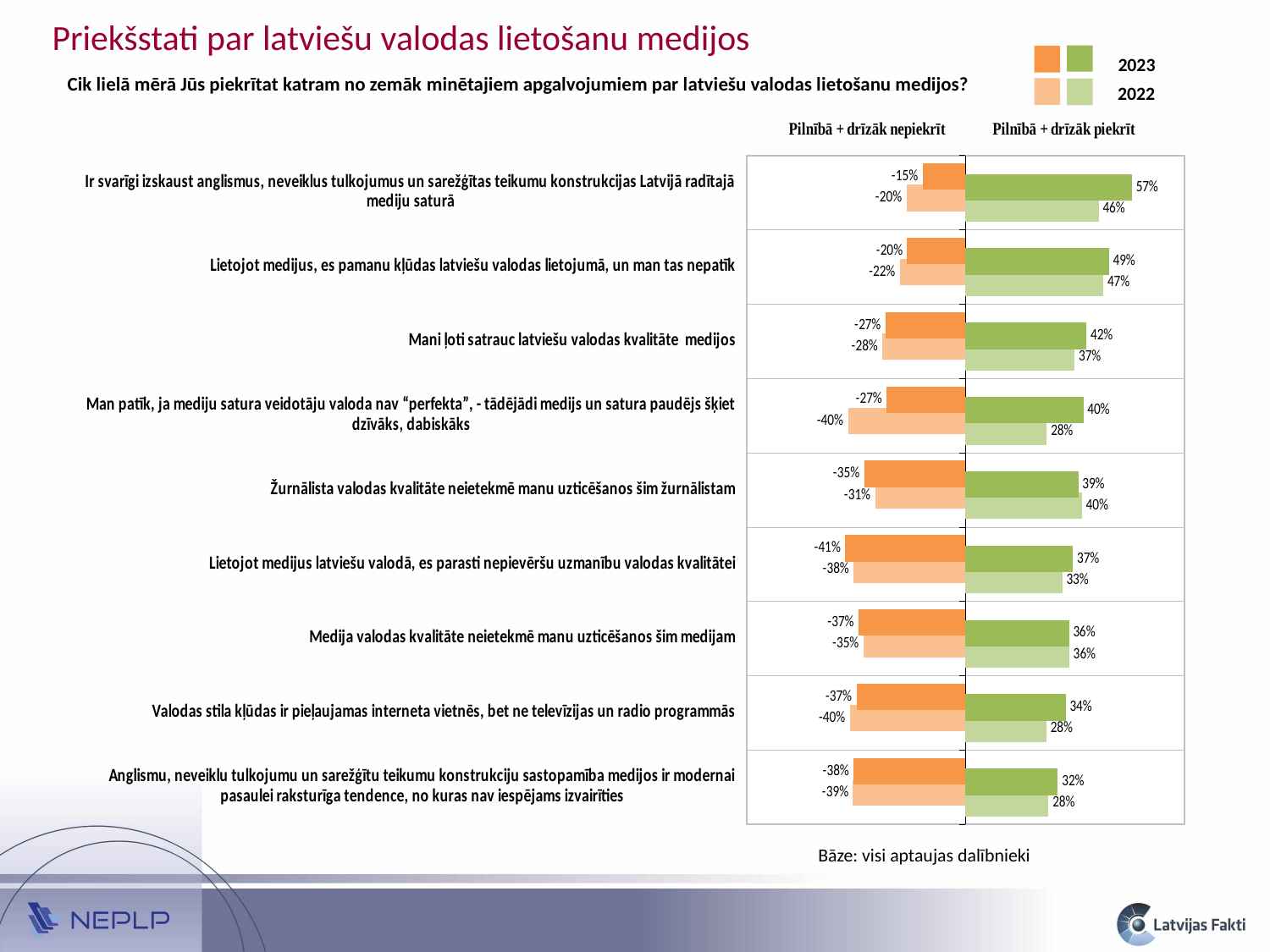
How many years does the legend list? 2 What is the 2023 'Pilnībā + drīzāk nepiekrīt' value for 'Lietojot medijus latviešu valodā, es parasti nepievēršu uzmanību valodas kvalitātei'? -41% Which is larger for 'Žurnālista valodas kvalitāte neietekmē manu uzticēšanos šim žurnālistam': the 2023 or the 2022 'Pilnībā + drīzāk piekrīt' value? 2022 Which statement has the highest 2023 'Pilnībā + drīzāk piekrīt' value? Ir svarīgi izskaust anglismus, neveiklus tulkojumus un sarežģītas teikumu konstrukcijas Latvijā radītajā mediju saturā What is the 2022 'Pilnībā + drīzāk piekrīt' value for 'Valodas stila kļūdas ir pieļaujamas interneta vietnēs, bet ne televīzijas un radio programmās'? 28% Which colour represents the 2023 'Pilnībā + drīzāk piekrīt' values? Green What type of chart is shown on the slide? Bar chart What is the difference between the 2023 and 2022 'Pilnībā + drīzāk piekrīt' values for 'Ir svarīgi izskaust anglismus...'? 11 percentage points What is the 2023 'Pilnībā + drīzāk piekrīt' value for 'Mani ļoti satrauc latviešu valodas kvalitāte medijos'? 42% What is the 2022 'Pilnībā + drīzāk nepiekrīt' value for 'Man patīk, ja mediju satura veidotāju valoda nav “perfekta”...'? -40% How many statements are shown in the chart? 9 Which statement has the lowest 2023 'Pilnībā + drīzāk piekrīt' value? Anglismu, neveiklu tulkojumu un sarežģītu teikumu konstrukciju sastopamība medijos ir modernai pasaulei raksturīga tendence, no kuras nav iespējams izvairīties